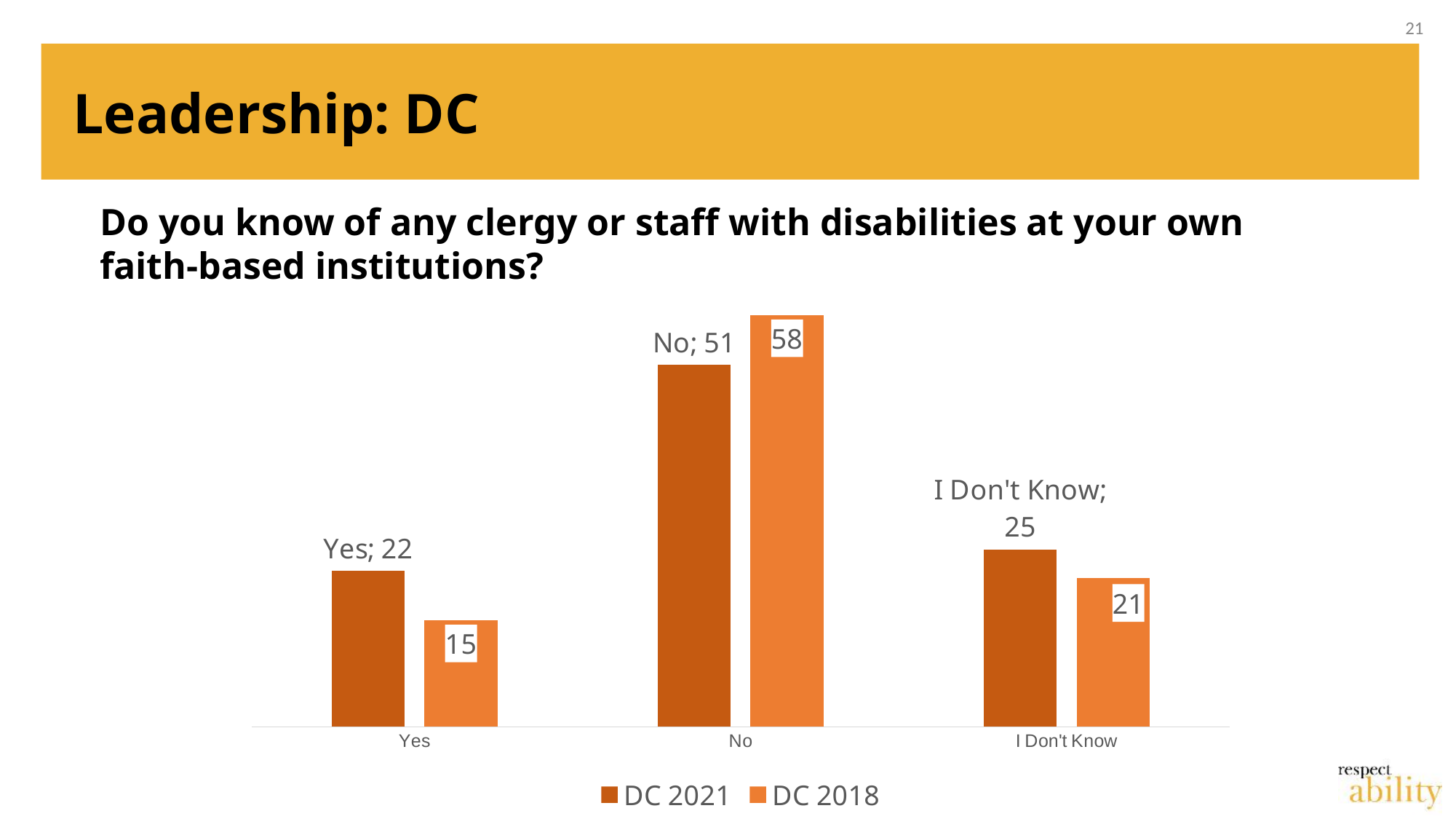
What are the two series named in the legend? DC 2021 and DC 2018 Which category has the lowest value in the DC 2018 series? Yes Which category has the highest value in the DC 2021 series? No What is the difference between the DC 2018 and DC 2021 values for "No"? 7 How many series does the legend list? 2 How many categories are shown on the x axis? 3 What is the value for "No" in the DC 2018 series? 58 What kind of chart is shown on the slide? Bar chart What is the value for "Yes" in the DC 2021 series? 22 What is the value for "Yes" in the DC 2018 series? 15 Which is larger for "I Don't Know": the DC 2021 value or the DC 2018 value? DC 2021 What is the value for "I Don't Know" in the DC 2021 series? 25